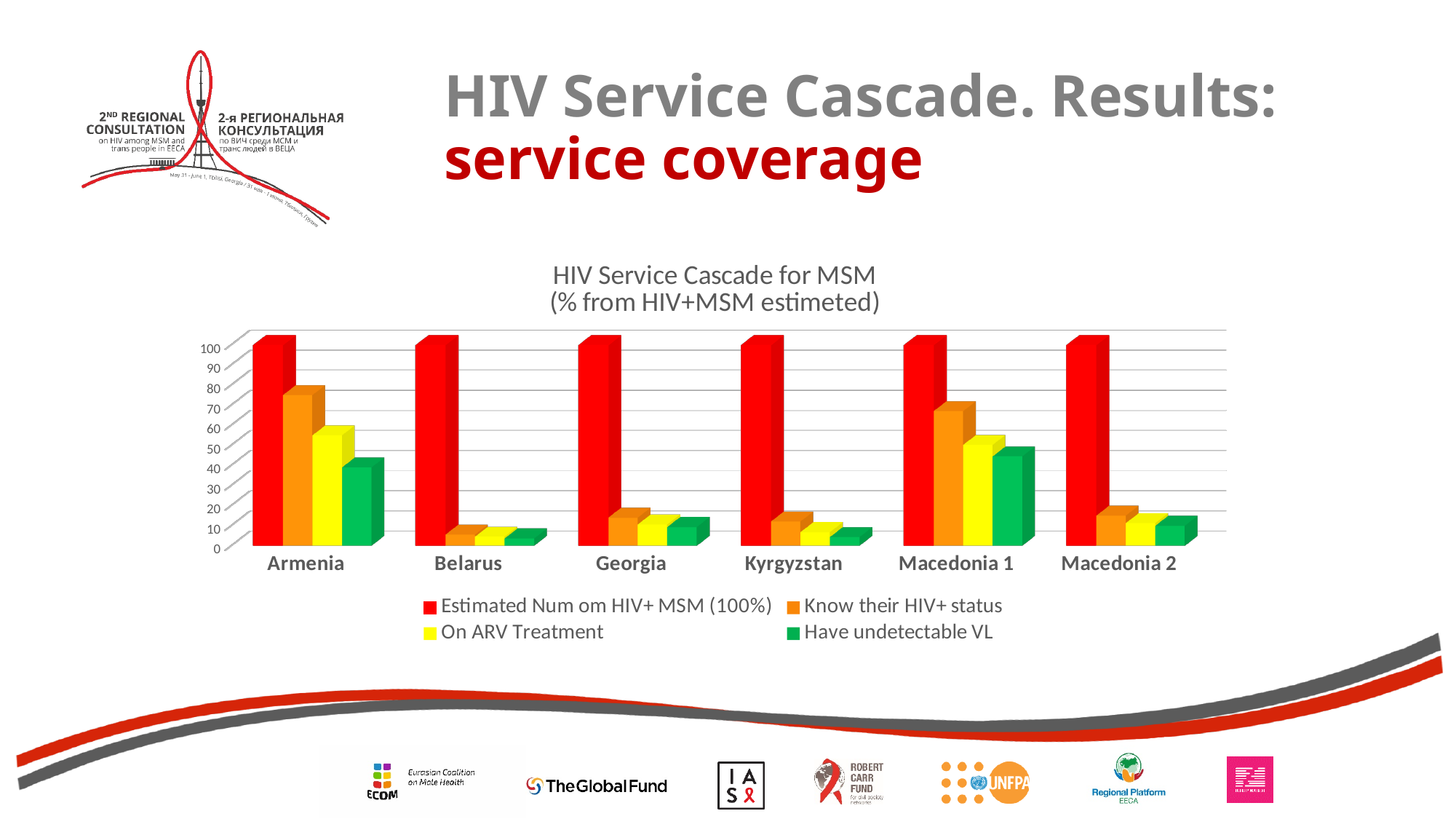
What is the value of the 'Estimated Num om HIV+ MSM' bar for Belarus? 100 Which series is shown in green in the chart legend? Have undetectable VL Is the 'Know their HIV+ status' value for Macedonia 1 greater or less than 60? greater Which country has the lowest value for 'Know their HIV+ status'? Belarus Which is larger: the 'Know their HIV+ status' value for Armenia or for Georgia? Armenia How many countries (categories) are shown on the x axis of the chart? 6 Is the 'Have undetectable VL' value for Georgia greater or less than 20? less What kind of chart is shown on the slide? bar chart Which country has the highest value for 'Know their HIV+ status'? Armenia Is the 'On ARV Treatment' value for Armenia greater or less than 50? greater How many series does the chart legend list? 4